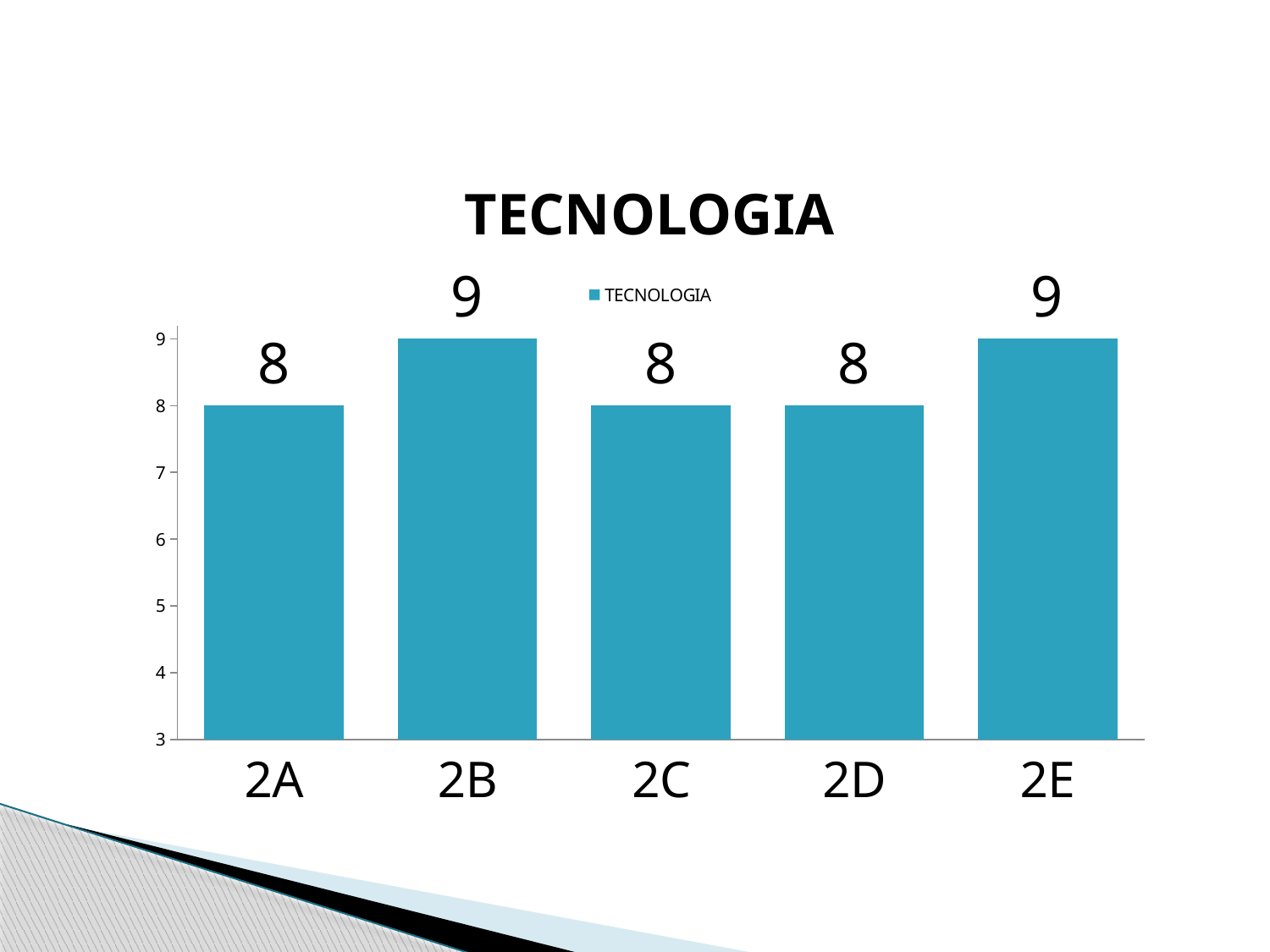
What is the title of the chart? TECNOLOGIA Is the value for 2C greater or less than 5? greater What is the lowest value shown on the y axis? 3 What is the value for 2B? 9 What is the difference between the values for 2B and 2C? 1 What is the value for 2E? 9 Which is larger, the value for 2E or the value for 2D? 2E What is the value for 2A? 8 How many categories are shown on the x axis? 5 What is the value for 2D? 8 What kind of chart is shown? bar chart How many series does the legend list? 1